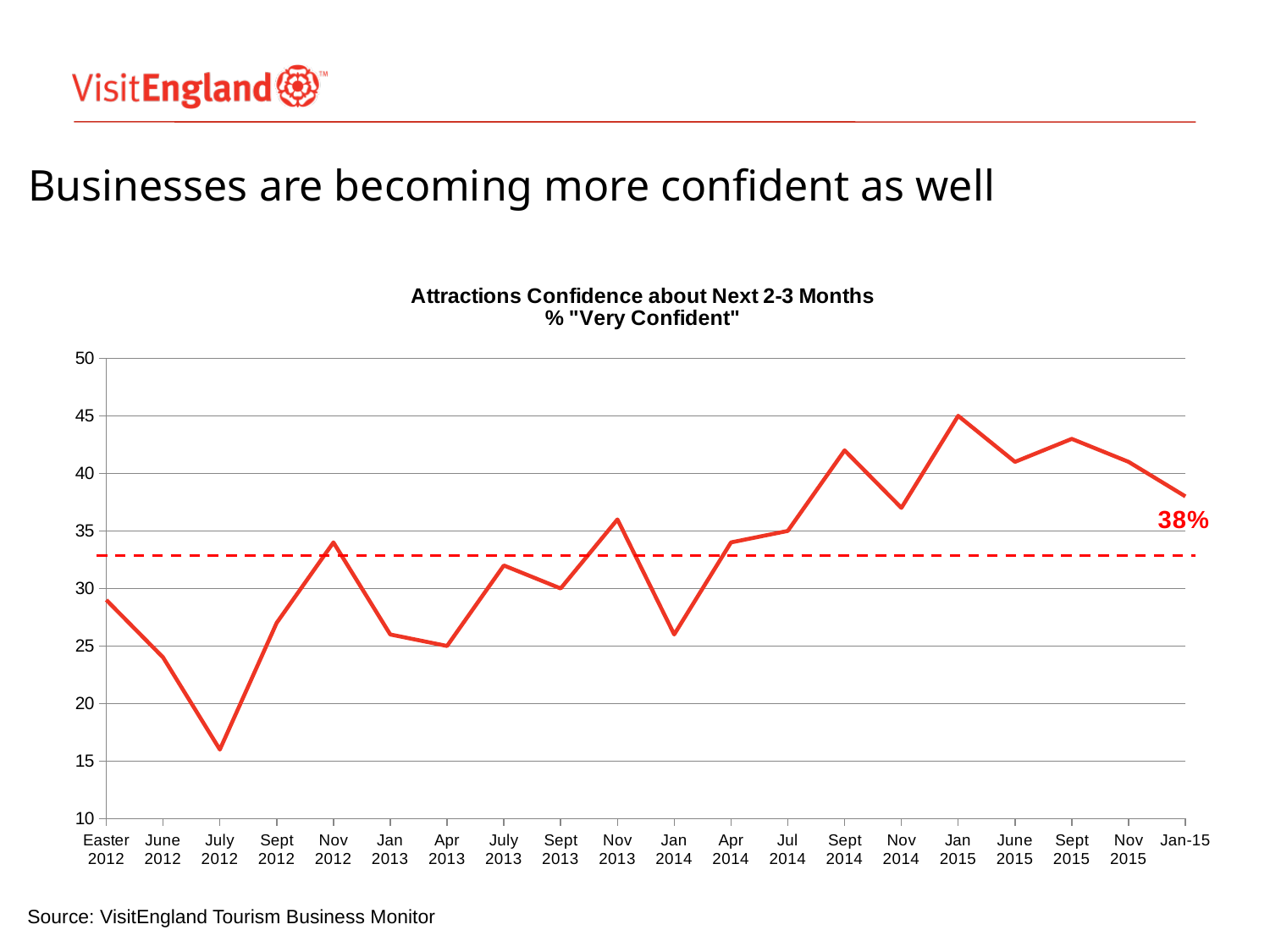
Is the value for Sept 2014 greater or less than 40? greater Overall, do the values rise or fall from Easter 2012 to Jan-15? rise Which period has the lowest % "Very Confident" value? July 2012 What kind of chart is shown on the slide? line chart Which is higher, the value for Easter 2012 or the value for Jan 2015? Jan 2015 Which period has the highest % "Very Confident" value? Jan 2015 Is the value for Jan 2014 greater or less than 30? less Which is higher, the value for Sept 2014 or the value for Nov 2014? Sept 2014 What is the title of the chart? Attractions Confidence about Next 2-3 Months % "Very Confident" How many time periods are plotted along the x axis? 20 What value is labelled for Jan-15 at the right end of the line? 38% Is the value for July 2012 greater or less than 20? less